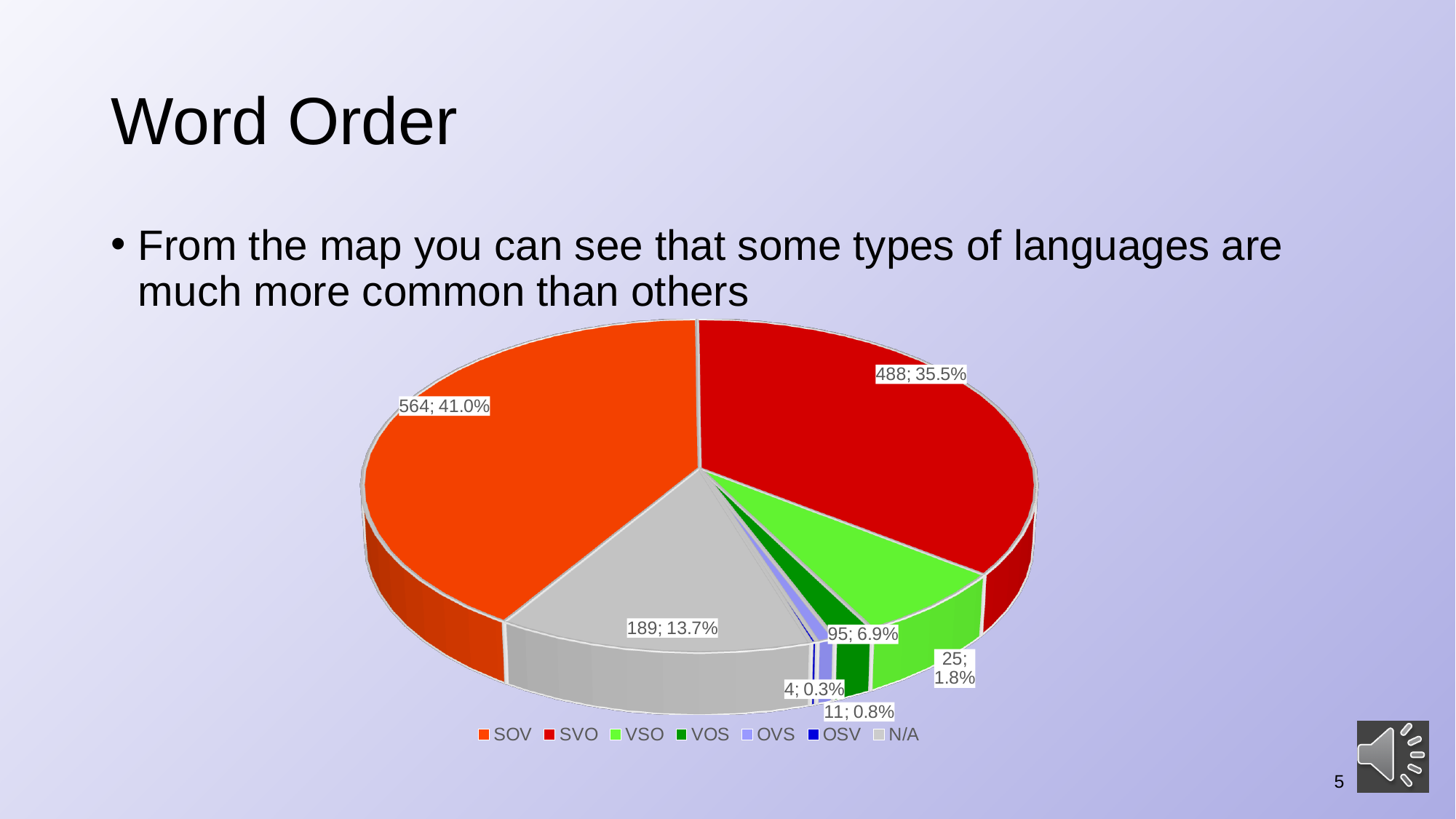
What is the count shown for SVO? 488 What is the difference between the SOV count and the SVO count? 76 How many slices does the pie chart have? 7 What colour is used for the SOV slice in the legend? orange Which word order category has the largest slice of the pie? SOV What percentage of the pie does SVO account for? 35.5% What percentage of the pie does SOV account for? 41.0% What is the count shown for the N/A slice? 189 How many entries does the chart's legend list? 7 What is the count shown for SOV? 564 What kind of chart is shown on the slide? pie chart Which is larger, the SOV slice or the SVO slice? SOV